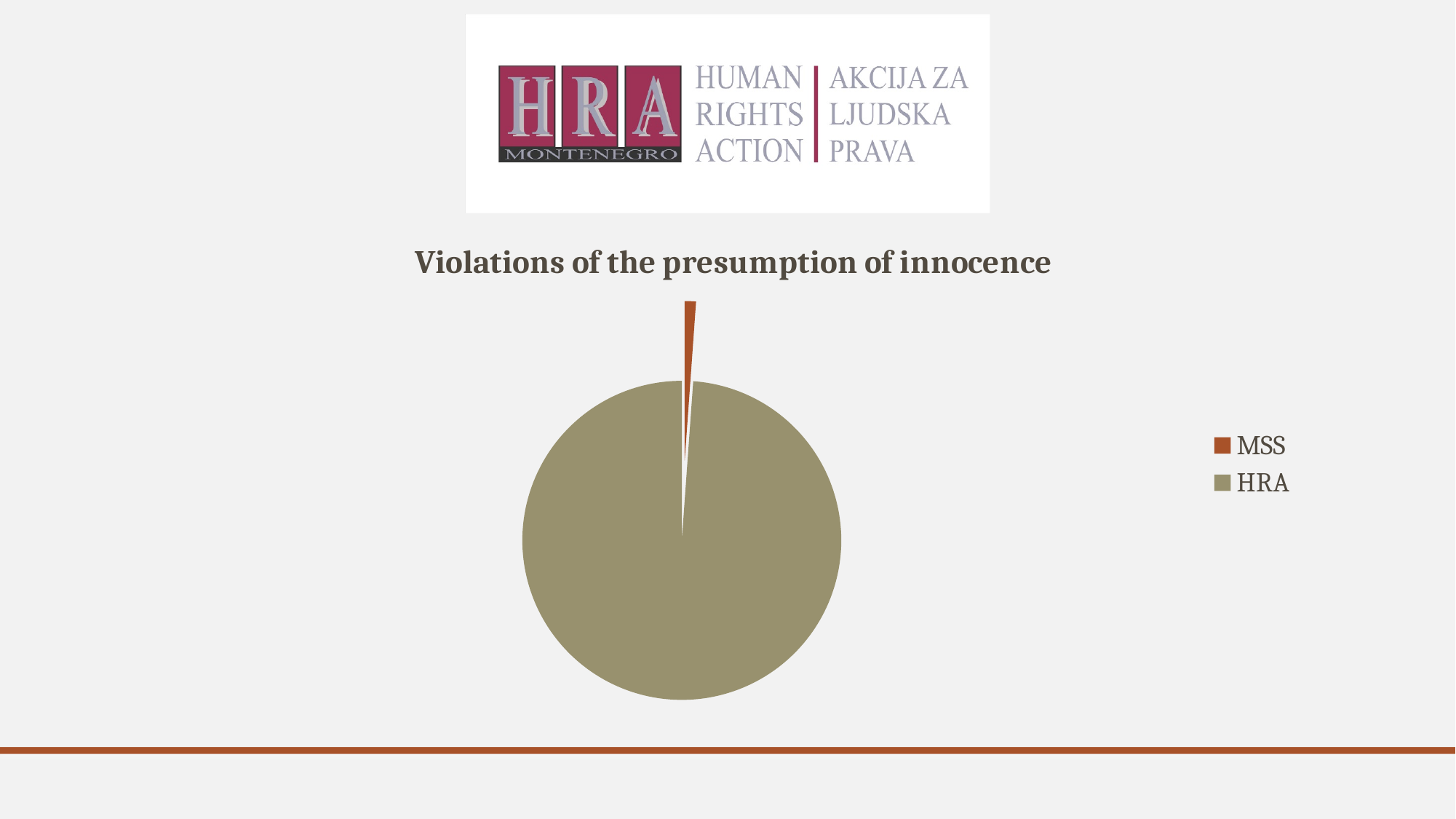
Which slice is larger, MSS or HRA? HRA How many categories does the legend list? 2 What is the title of the chart? Violations of the presumption of innocence Does the HRA slice take up more or less than half of the pie? more Which legend entry is shown in the orange-brown colour? MSS What kind of chart is shown on the slide? pie chart Which category has the largest slice of the pie? HRA Which category has the smallest slice of the pie? MSS